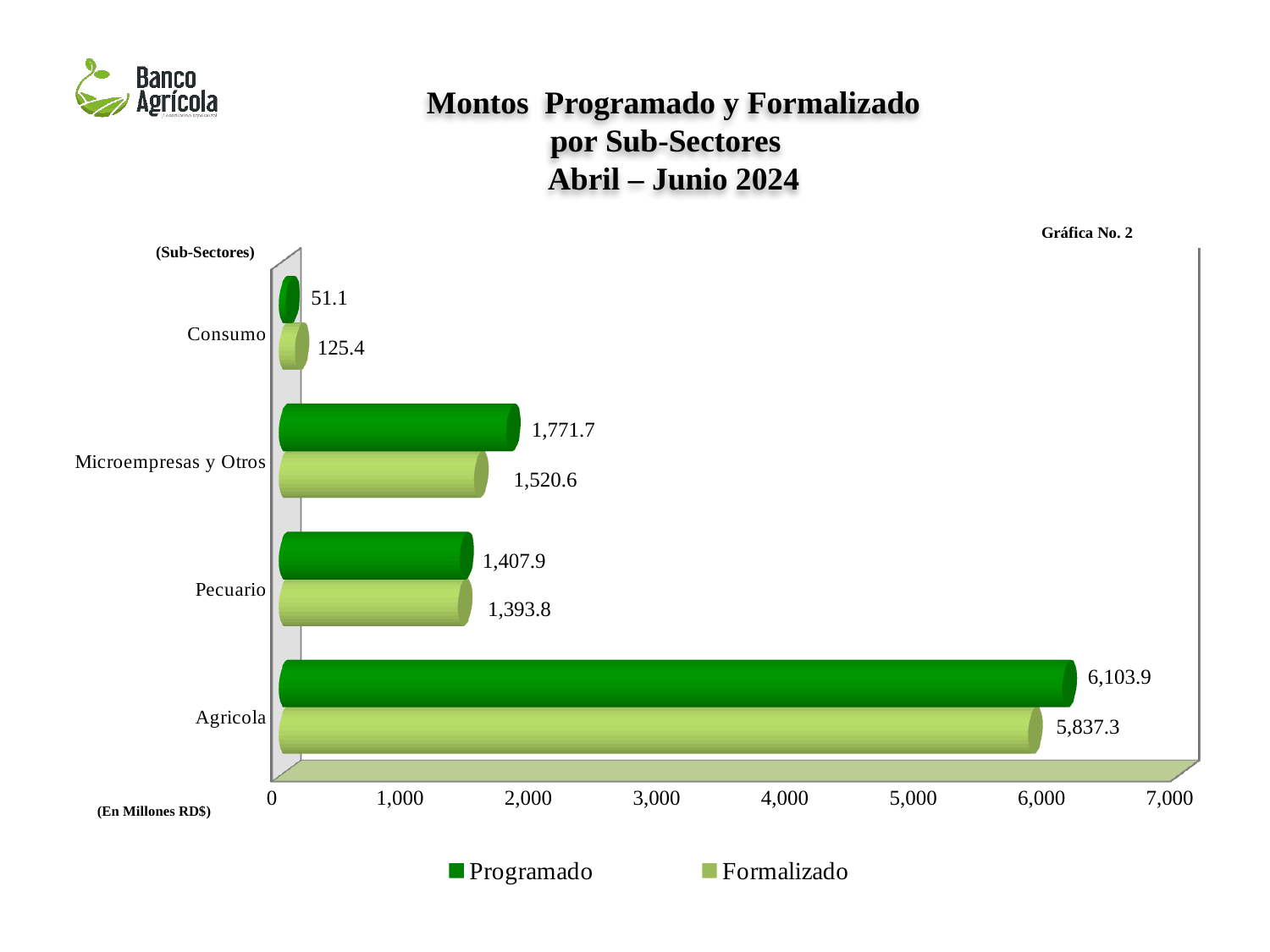
Which sub-sector has the highest Programado value? Agricola What is the Programado value for Agricola? 6,103.9 How many sub-sectors are shown on the chart? 4 How many series does the legend list? 2 Is the Programado value for Pecuario greater or less than 1,000? greater What kind of chart is shown on the slide? Bar chart For Consumo, which is larger: Programado or Formalizado? Formalizado What is the Formalizado value for Consumo? 125.4 What is the difference between the Programado and Formalizado values for Agricola? 266.6 Which sub-sector has the lowest Formalizado value? Consumo What is the Formalizado value for Microempresas y Otros? 1,520.6 What is the difference between the Programado and Formalizado values for Microempresas y Otros? 251.1